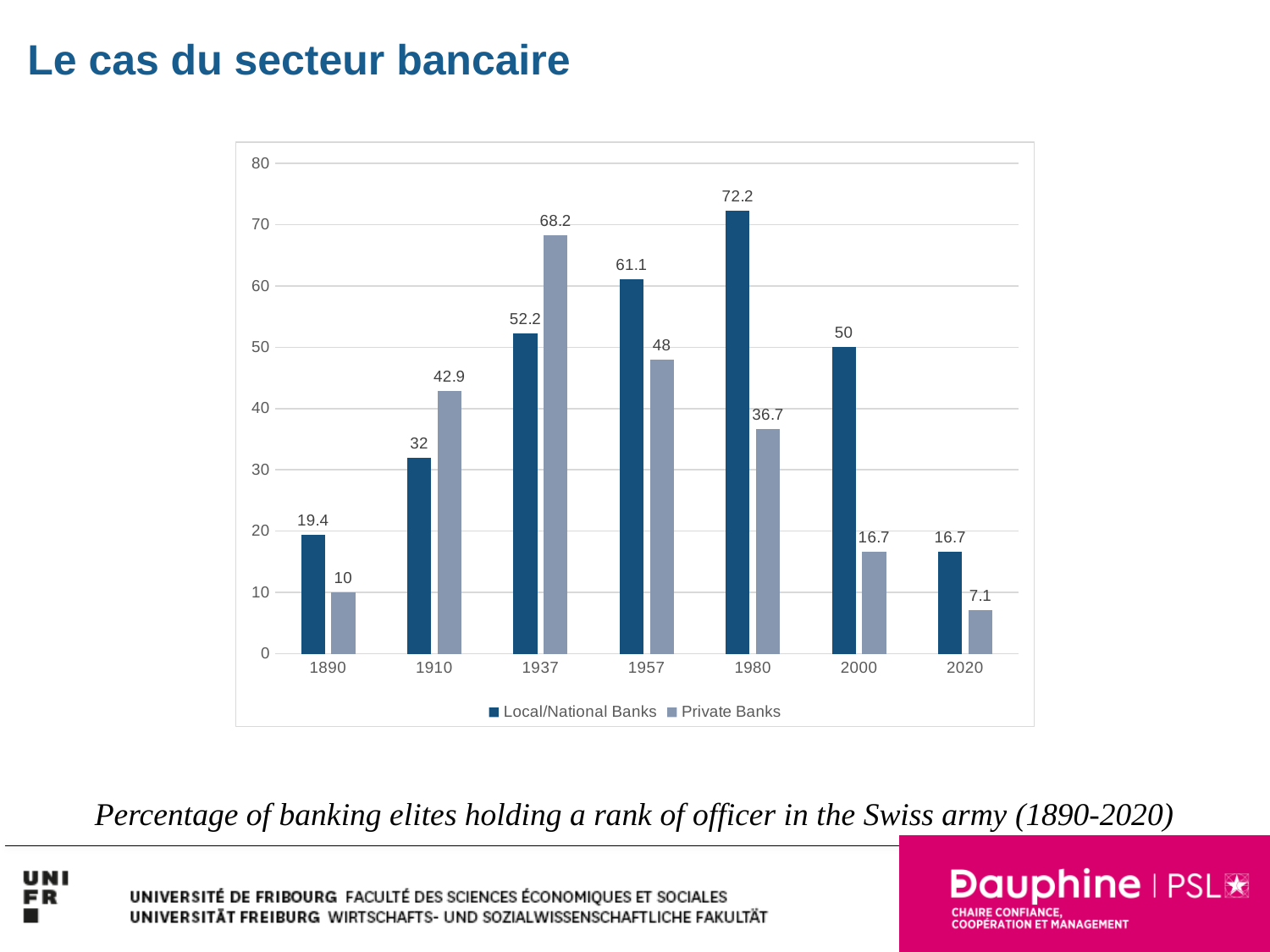
How many series does the legend list? 2 In which year is the Private Banks value lowest? 2020 What is the difference between Local/National Banks and Private Banks in 1980? 35.5 What is the value for Private Banks in 2020? 7.1 How many years are shown on the x axis? 7 What is the value for Private Banks in 1937? 68.2 In which year is the Local/National Banks value highest? 1980 Which is larger in 1910: Local/National Banks or Private Banks? Private Banks What kind of chart is shown? Bar chart Does the Local/National Banks value rise or fall from 1980 to 2020? Fall What does the caption below the chart say the chart shows? Percentage of banking elites holding a rank of officer in the Swiss army (1890-2020) What is the value for Local/National Banks in 1980? 72.2